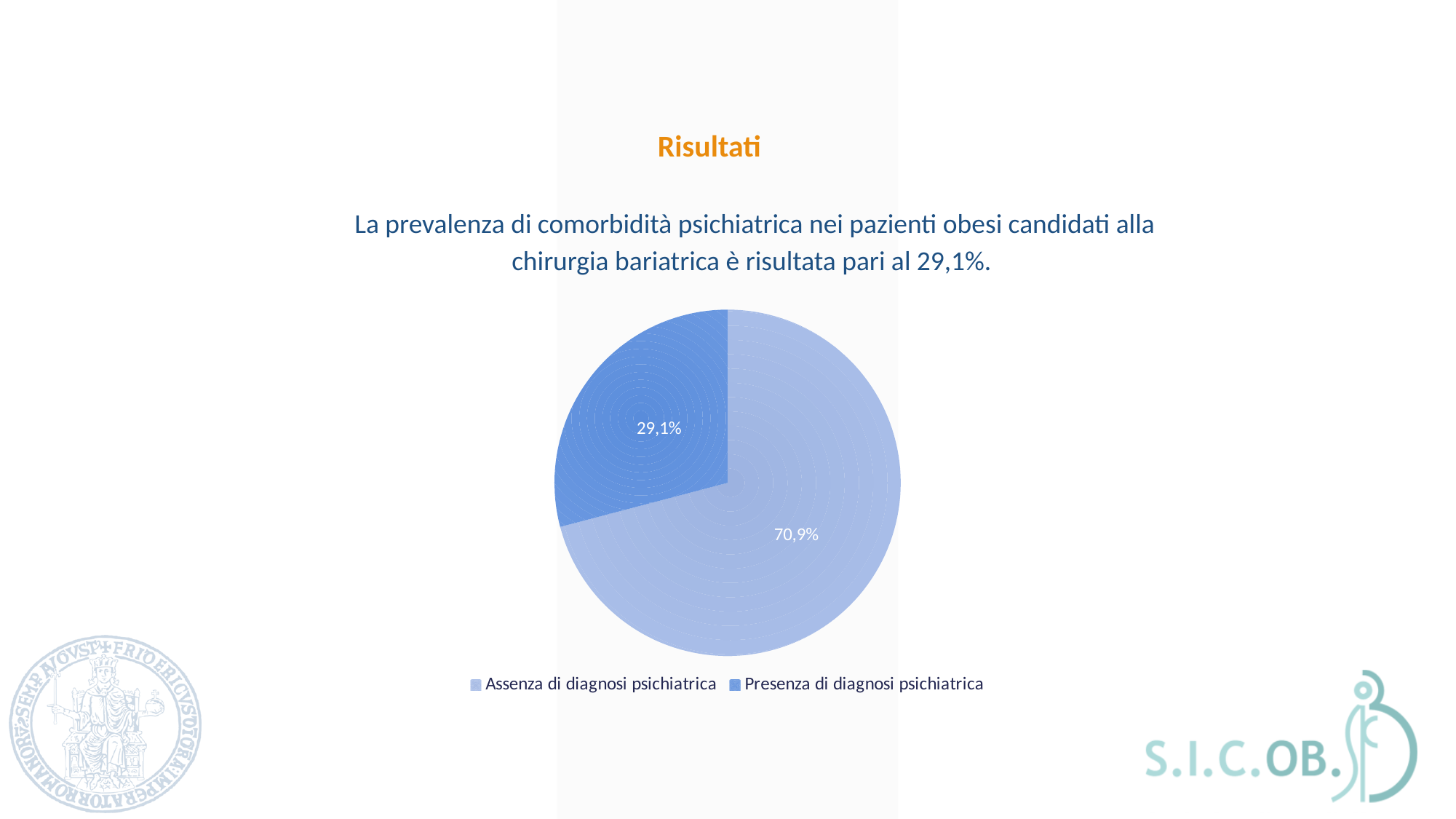
Which legend entry is shown with the lighter blue colour? Assenza di diagnosi psichiatrica What kind of chart is shown on the slide? pie chart How many slices does the pie chart have? 2 Which slice of the pie is the smallest? Presenza di diagnosi psichiatrica Which is larger: the 'Assenza di diagnosi psichiatrica' slice or the 'Presenza di diagnosi psichiatrica' slice? Assenza di diagnosi psichiatrica Which slice of the pie is the largest? Assenza di diagnosi psichiatrica How many entries does the legend list? 2 What share of the pie is labelled 'Presenza di diagnosi psichiatrica'? 29,1% What share of the pie is labelled 'Assenza di diagnosi psichiatrica'? 70,9% What is the value printed on the darker blue slice of the pie? 29,1% What is the title shown above the chart on the slide? Risultati What is the difference in percentage points between the 'Assenza di diagnosi psichiatrica' slice and the 'Presenza di diagnosi psichiatrica' slice? 41,8